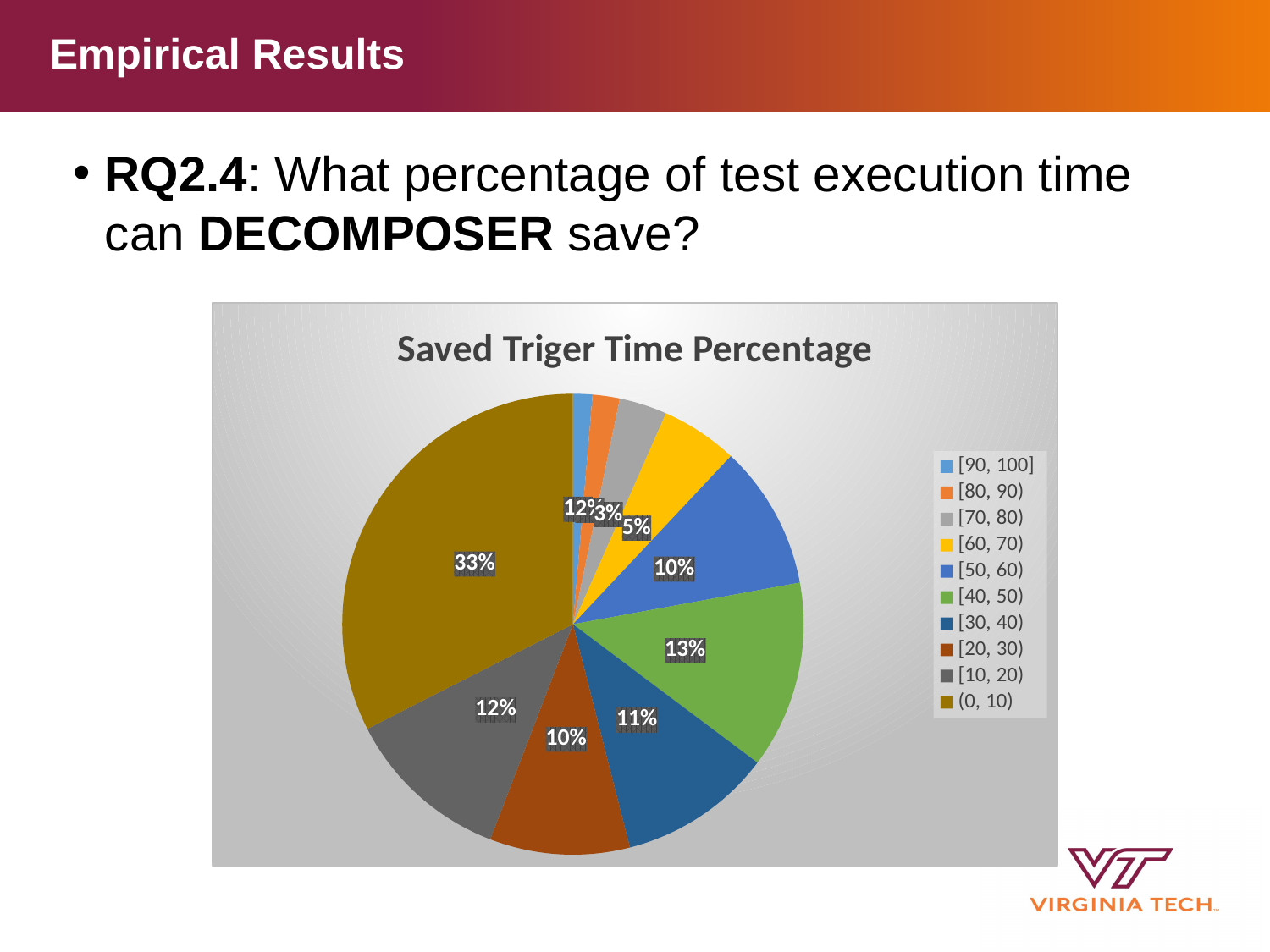
What is the title of the chart? Saved Triger Time Percentage What kind of chart is shown on the slide? pie chart Which is larger, the [40, 50) slice or the [60, 70) slice? [40, 50) Which category has the largest slice of the pie? (0, 10) What share of the pie does the (0, 10) slice have? 33% What share of the pie does the [40, 50) slice have? 13% What share of the pie does the [30, 40) slice have? 11% How many categories does the legend of the pie chart list? 10 What colour is the (0, 10) slice in the pie chart? dark yellow (olive gold) What is the difference between the (0, 10) share and the [10, 20) share? 21%